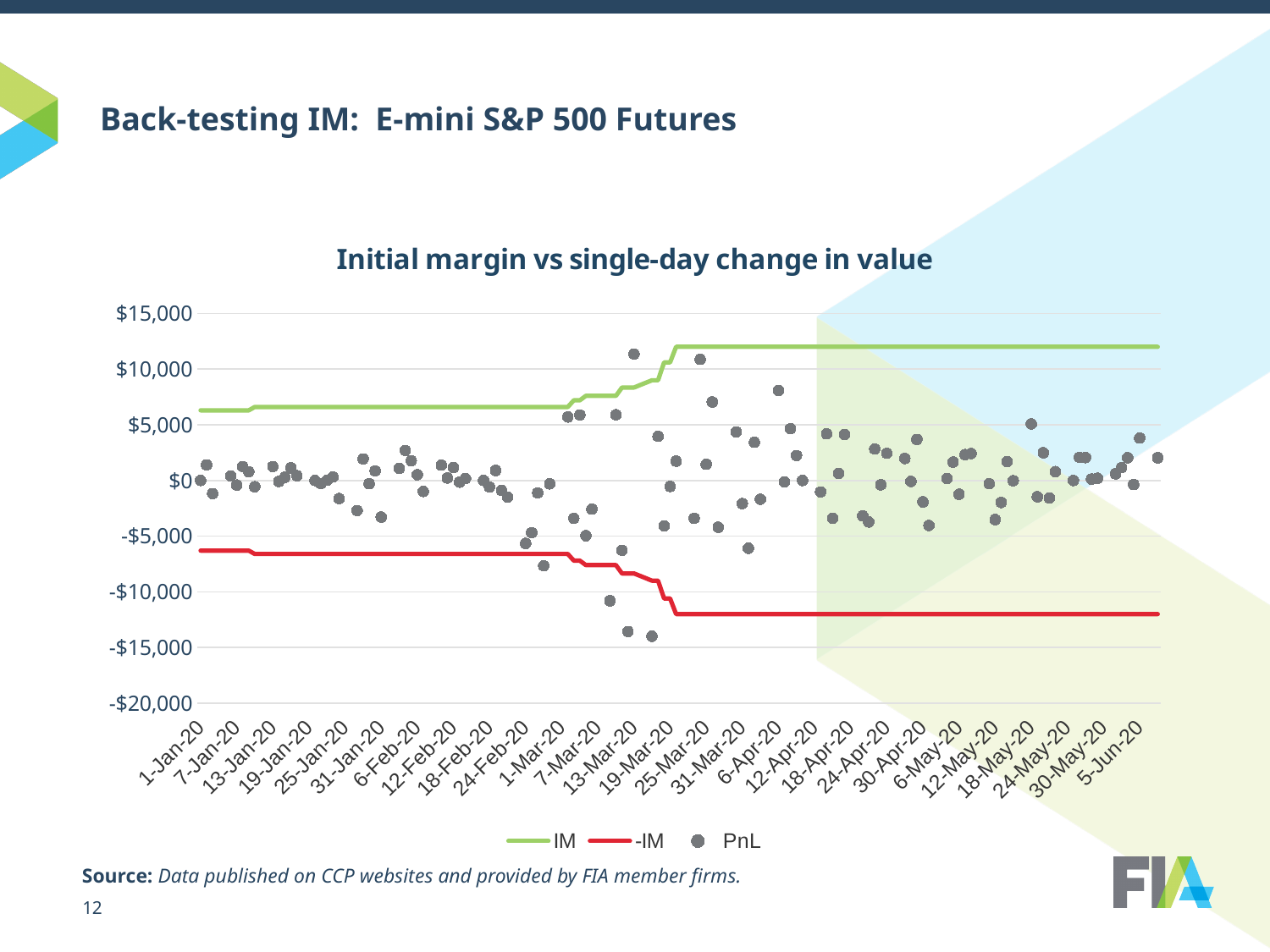
Does the IM line rise or fall from 1-Jan-20 to 5-Jun-20? rise Is the value of the IM line on 1-Jan-20 greater or less than $10,000? less Which is larger, the IM value on 5-Jun-20 or the IM value on 1-Jan-20? 5-Jun-20 Does the -IM line rise or fall from 1-Jan-20 to 5-Jun-20? fall What are the series names listed in the chart legend? IM, -IM, PnL Is the value of the -IM line on 1-Jan-20 greater or less than -$10,000? greater Which series is plotted as scattered dots rather than a line? PnL Is the value of the IM line on 5-Jun-20 greater or less than $10,000? greater What is the title of the chart? Initial margin vs single-day change in value How many series does the chart legend list? 3 What is the highest value shown on the vertical axis? $15,000